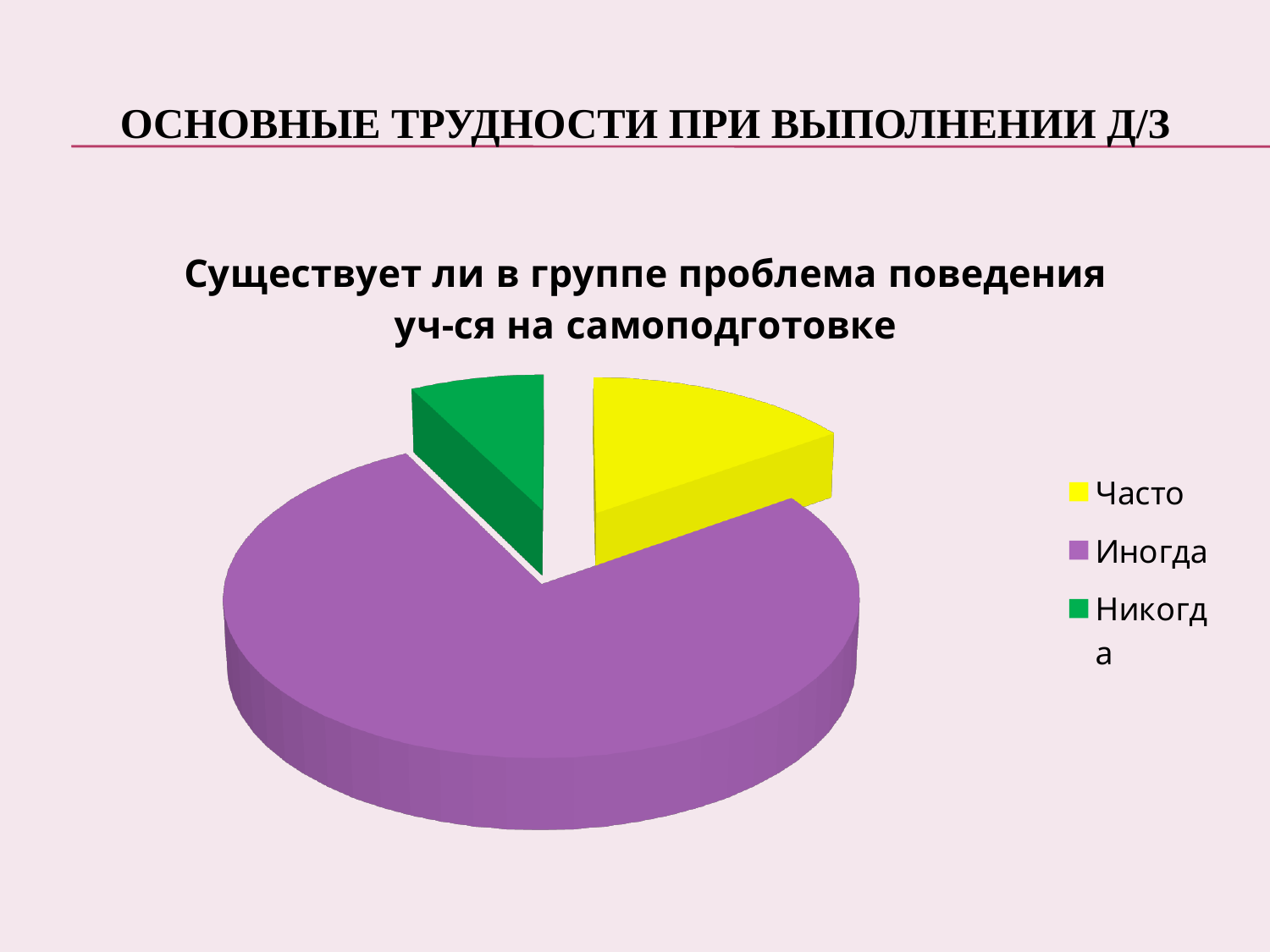
Which category has the smallest slice in the pie chart? Никогда Which slice is larger in the pie chart, Иногда or Часто? Иногда Which slice is larger in the pie chart, Часто or Никогда? Часто Which category has the largest slice in the pie chart? Иногда Which colour represents the category Иногда in the pie chart? Purple How many slices does the pie chart have? 3 What is the title of the pie chart? Существует ли в группе проблема поведения уч-ся на самоподготовке How many entries does the legend of the pie chart list? 3 What kind of chart is shown on the slide? Pie chart